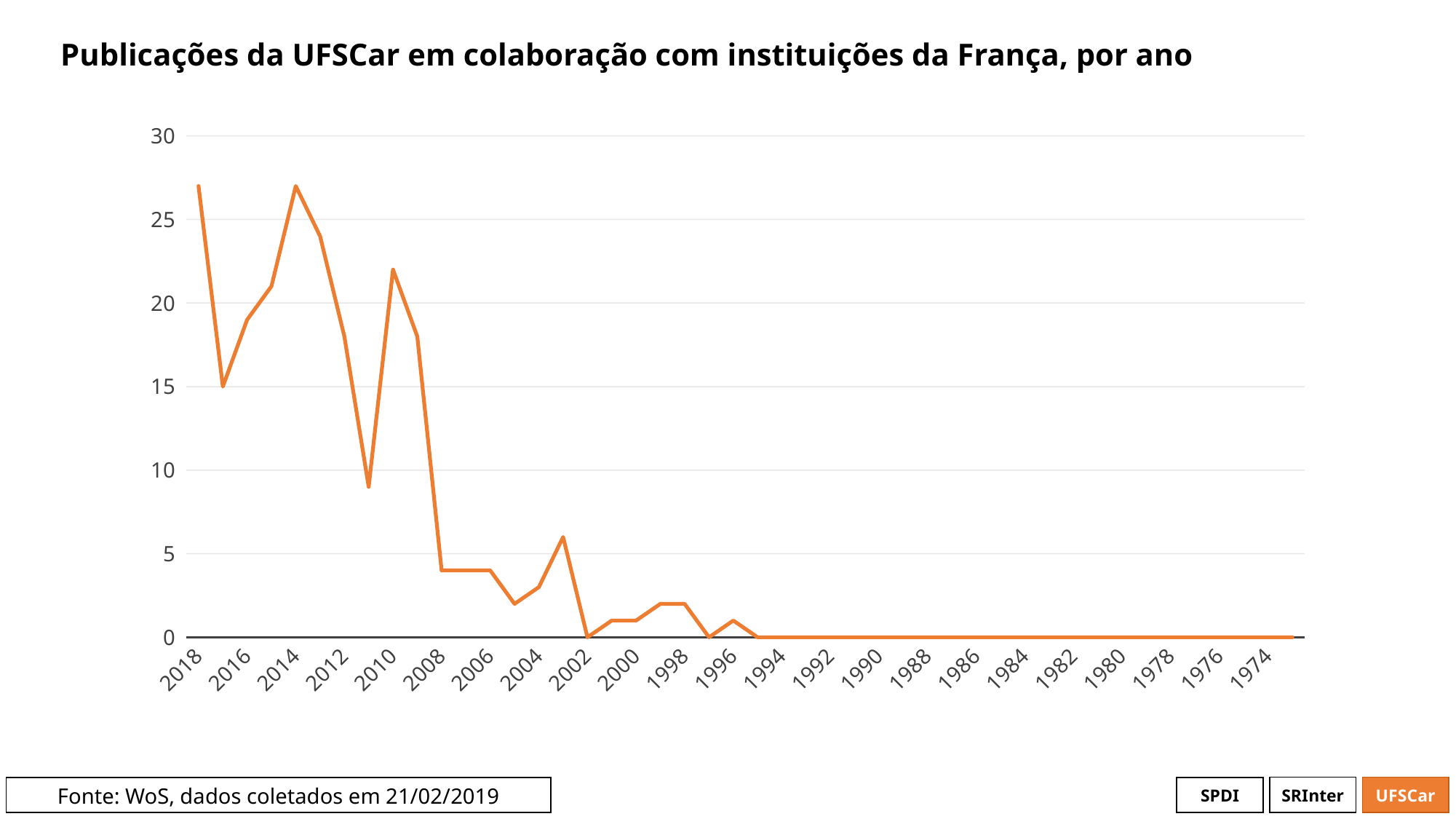
Is the value for 2011 greater or less than 10? less Moving from left (2018) to right (1974) along the x axis, do the values generally rise or fall? fall Is the value for 2008 greater or less than 5? less What colour is the line in the chart? orange What is the value for 1990? 0 Is the value for 2010 greater or less than 20? greater What kind of chart is shown on the slide? line chart What is the value for 2002? 0 What is the title of the chart? Publicações da UFSCar em colaboração com instituições da França, por ano Which year has the larger value, 2010 or 2011? 2010